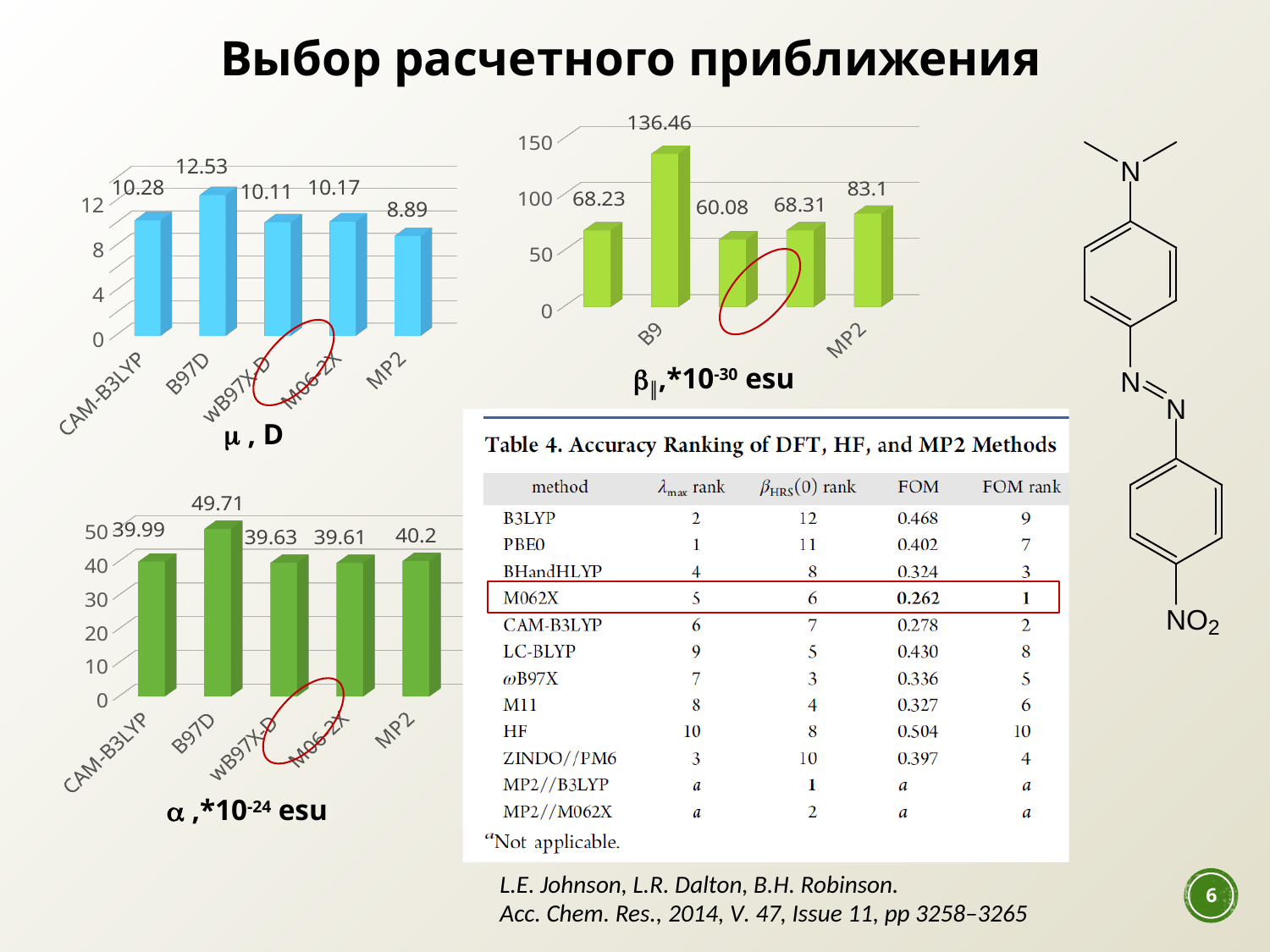
In the β∥, *10^-30 esu chart, what is the highest value shown? 136.46 In the μ, D chart, which category has the lowest value? MP2 In the μ, D chart, what is the difference between the values for B97D and CAM-B3LYP? 2.25 What type of chart is the α, *10^-24 esu chart? bar chart In the α, *10^-24 esu chart, what is the value for CAM-B3LYP? 39.99 In the β∥, *10^-30 esu chart, is the value for MP2 greater or less than 100? less In the α, *10^-24 esu chart, which is larger, the value for B97D or the value for MP2? B97D In the α, *10^-24 esu chart, what is the value for B97D? 49.71 In the μ, D chart, what is the value for B97D? 12.53 In the μ, D chart, how many bars are plotted? 5 In the β∥, *10^-30 esu chart, what is the value for MP2? 83.1 In the μ, D chart, what is the value for MP2? 8.89